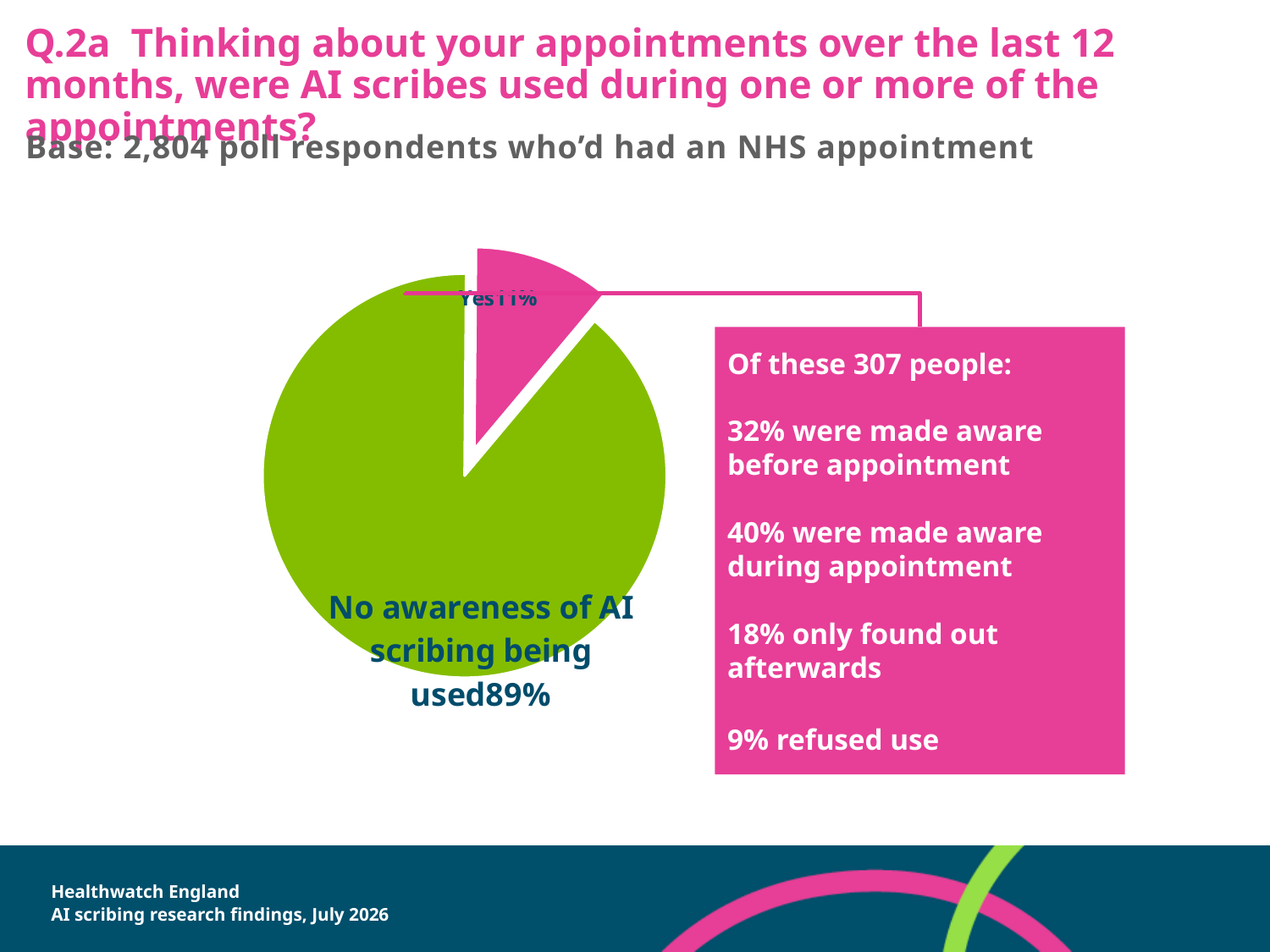
How many slices does the pie chart have? 2 What kind of chart is shown on the slide? pie chart What share of the pie is labelled "Yes"? 11% What colour is the "No awareness of AI scribing being used" slice of the pie chart? green What is the difference in percentage points between the "No awareness of AI scribing being used" slice and the "Yes" slice? 78 percentage points Which is larger in the pie chart: the "Yes" slice or the "No awareness of AI scribing being used" slice? No awareness of AI scribing being used Is the share for "Yes" greater or less than 25%? less Which slice of the pie chart is the smallest? Yes What colour is the "Yes" slice of the pie chart? pink What share of the pie is labelled "No awareness of AI scribing being used"? 89% Is the share for "No awareness of AI scribing being used" greater or less than 50%? greater Which slice of the pie chart is the largest? No awareness of AI scribing being used